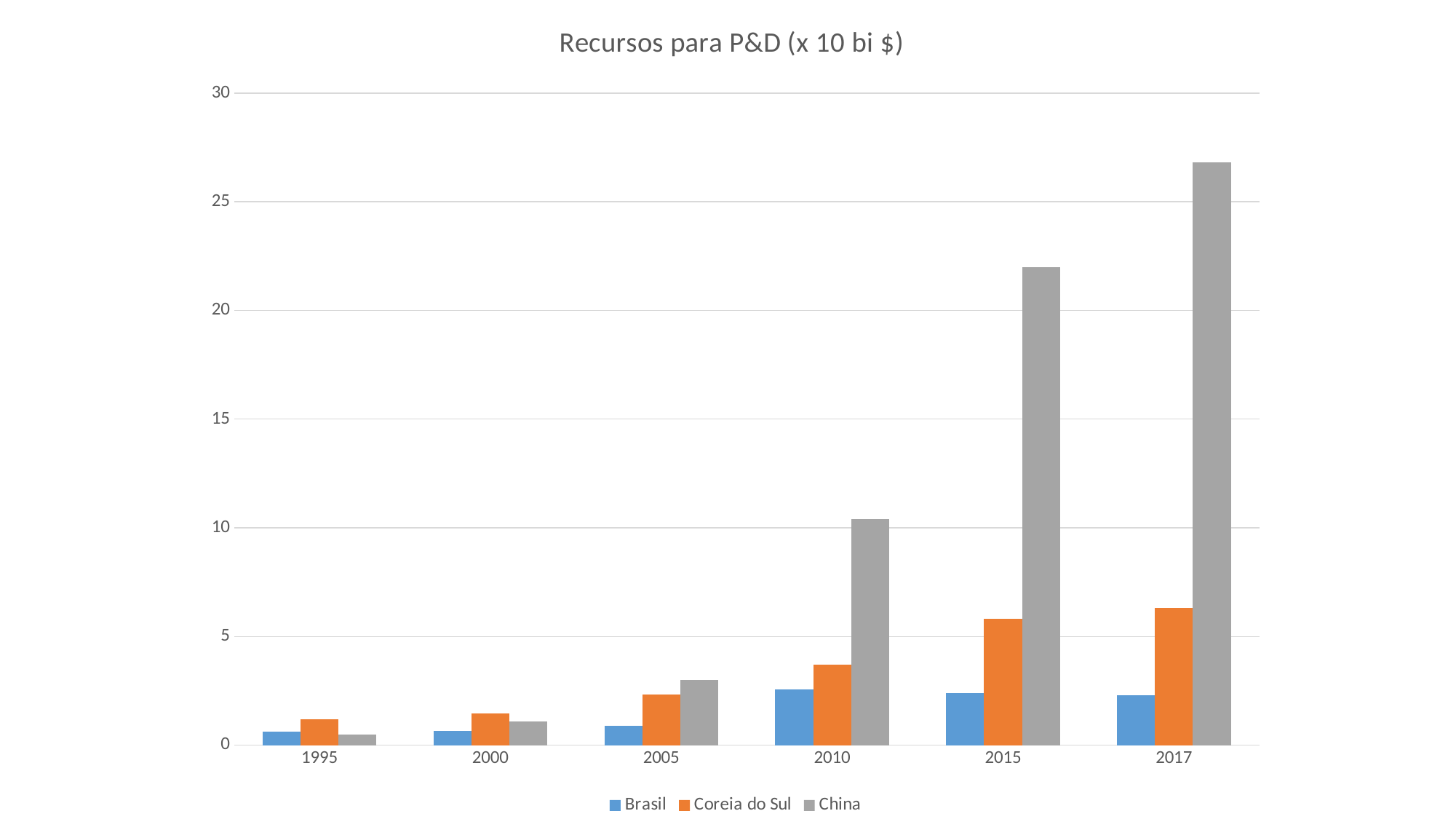
Is the value for China in 2010 greater or less than 15? less What kind of chart is shown on the slide? bar chart How many years are shown on the x axis? 6 Is the value for Coreia do Sul in 2017 greater or less than 5? greater In 2015, which is larger: the value for China or the value for Coreia do Sul? China How many series does the legend list? 3 Is the value for China in 2017 greater or less than 25? greater In which year is the value for China lowest? 1995 In which year is the value for China highest? 2017 Do the values for China rise or fall from 1995 to 2017? rise In 1995, which is larger: the value for Brasil or the value for Coreia do Sul? Coreia do Sul